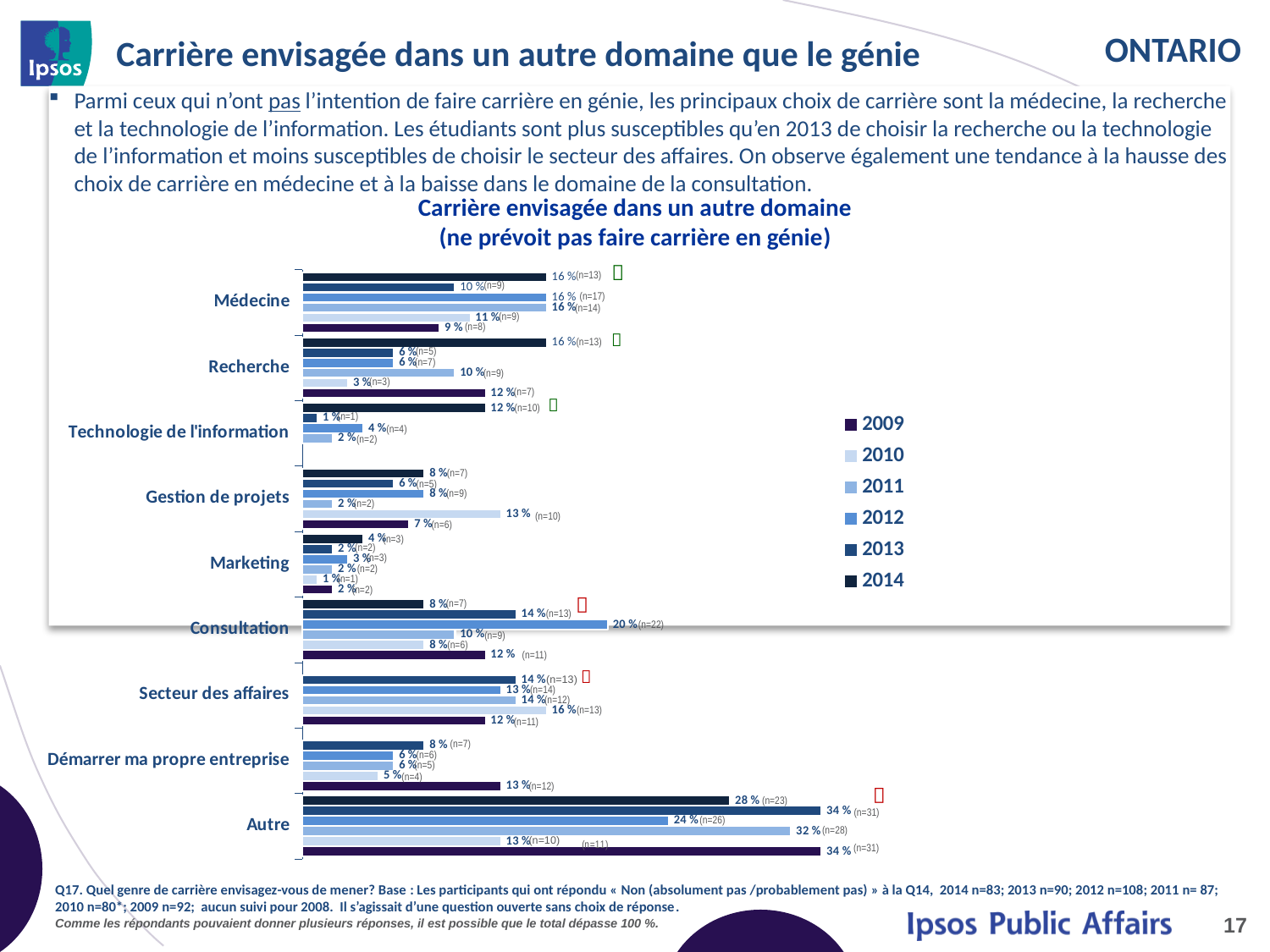
What is the 2014 value for Médecine? 16 % How many series does the legend list? 6 For Consultation, which is larger: the 2014 value or the 2009 value? 2009 What kind of chart is shown on the slide? bar chart What is the 2014 value for Autre? 28 % What is the 2009 value for Démarrer ma propre entreprise? 13 % Which category has the highest 2014 value? Autre What is the title of the chart? Carrière envisagée dans un autre domaine (ne prévoit pas faire carrière en génie) What is the 2009 value for Autre? 34 % What is the 2014 value for Technologie de l'information? 12 % How many career categories are shown on the chart? 9 What is the difference between the 2014 value for Autre and the 2014 value for Médecine? 12 %